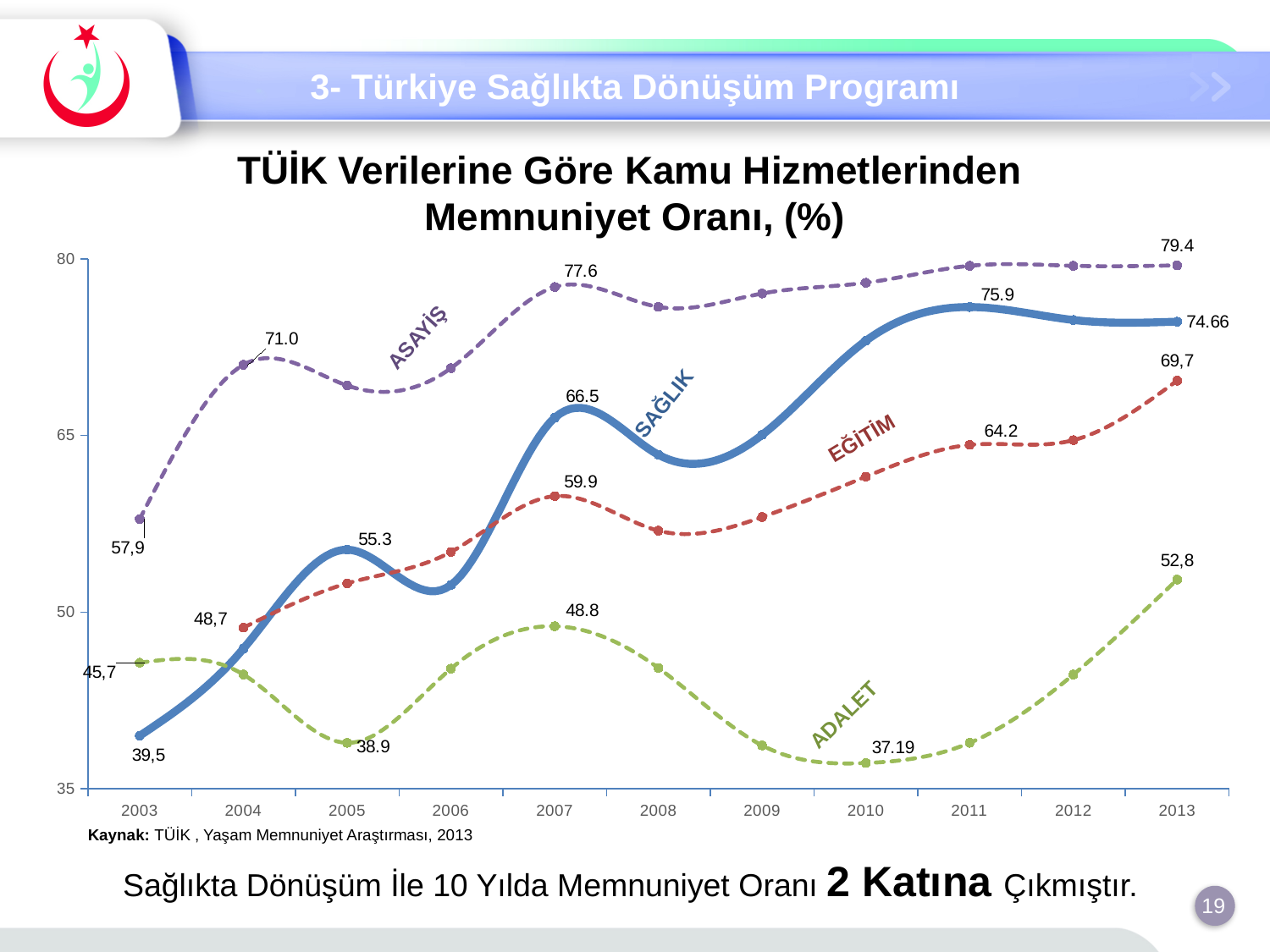
Which series has the lowest value in 2003? SAĞLIK What is the difference between the SAĞLIK values for 2011 and 2007? 9.4 Does the ADALET line rise or fall from 2010 to 2013? rise What is the ADALET value for 2010? 37.19 How many years are shown on the x axis? 11 Which is larger: the SAĞLIK value for 2011 or the ASAYİŞ value for 2007? ASAYİŞ value for 2007 What is the EĞİTİM value for 2013? 69,7 Which series has the highest value in 2013? ASAYİŞ What kind of chart is shown on the slide? line chart Is the EĞİTİM value for 2009 greater or less than 65? less What is the SAĞLIK value for 2013? 74.66 What is the ASAYİŞ value for 2007? 77.6